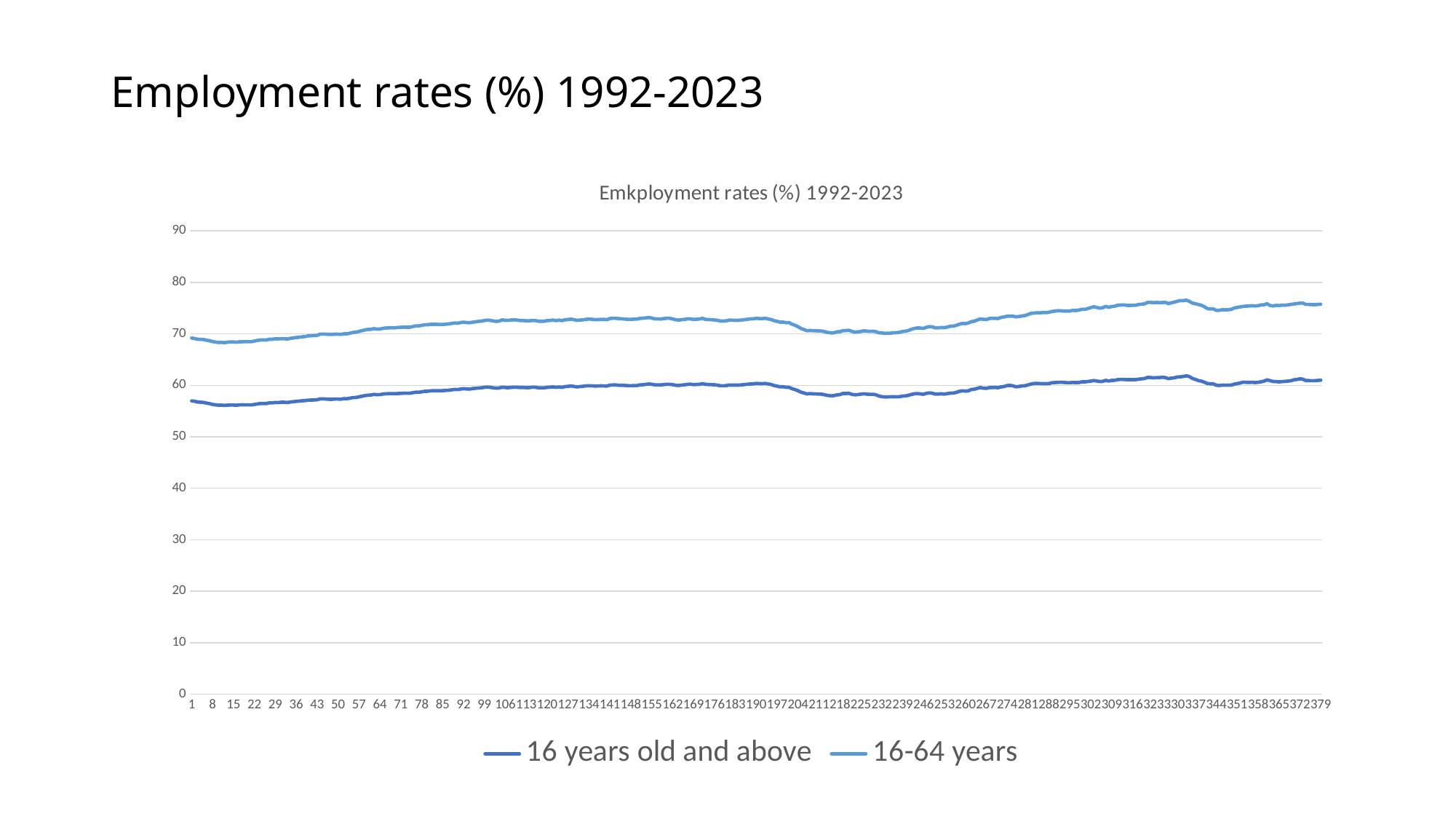
Is the value for the 16 years old and above series at x = 1 greater or less than 60? less What are the two series named in the legend? 16 years old and above; 16-64 years Comparing the start of the x axis to the end, do the values of the 16-64 years series rise or fall overall? rise What is the highest value labelled on the vertical axis? 90 What is the title printed above the chart? Emkployment rates (%) 1992-2023 Is the value for the 16-64 years series at x = 1 greater or less than 60? greater Does the 16 years old and above series ever rise above 70? No What kind of chart is shown on the slide? line chart How many series does the legend list? 2 Which series has the higher values throughout the chart, 16 years old and above or 16-64 years? 16-64 years